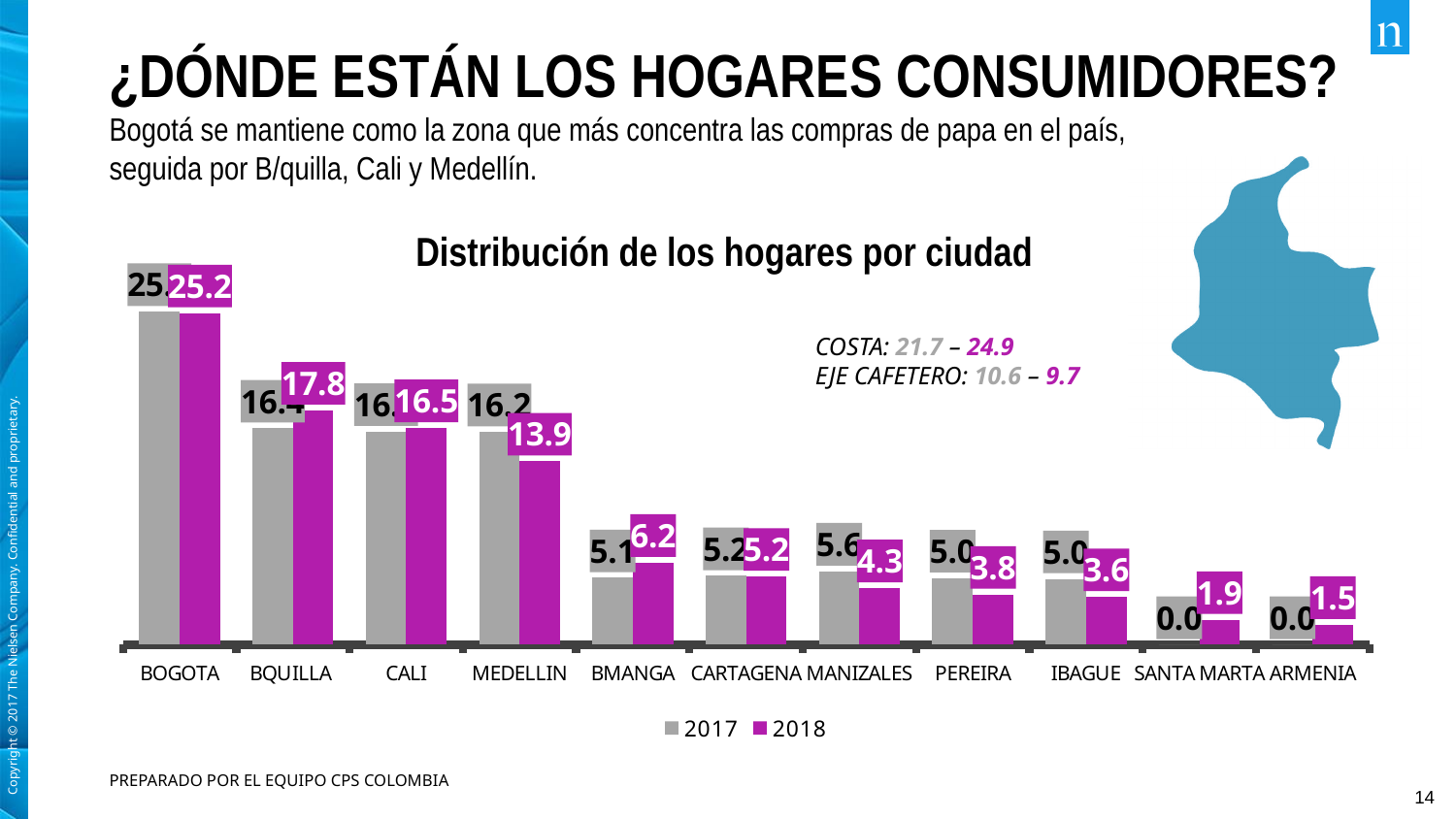
What is the 2018 value for BOGOTA? 25.2 What kind of chart is shown on the slide? Bar chart What is the difference between the 2017 and 2018 values for MEDELLIN? 2.3 Which city has the lowest 2018 value? ARMENIA For BMANGA, which year has the larger value, 2017 or 2018? 2018 What is the 2018 value for SANTA MARTA? 1.9 What is the 2017 value for MANIZALES? 5.6 What is the 2018 value for MEDELLIN? 13.9 How many series does the legend list? 2 Which city has the highest 2018 value? BOGOTA How many cities are shown on the x axis? 11 What is the title of the chart? Distribución de los hogares por ciudad